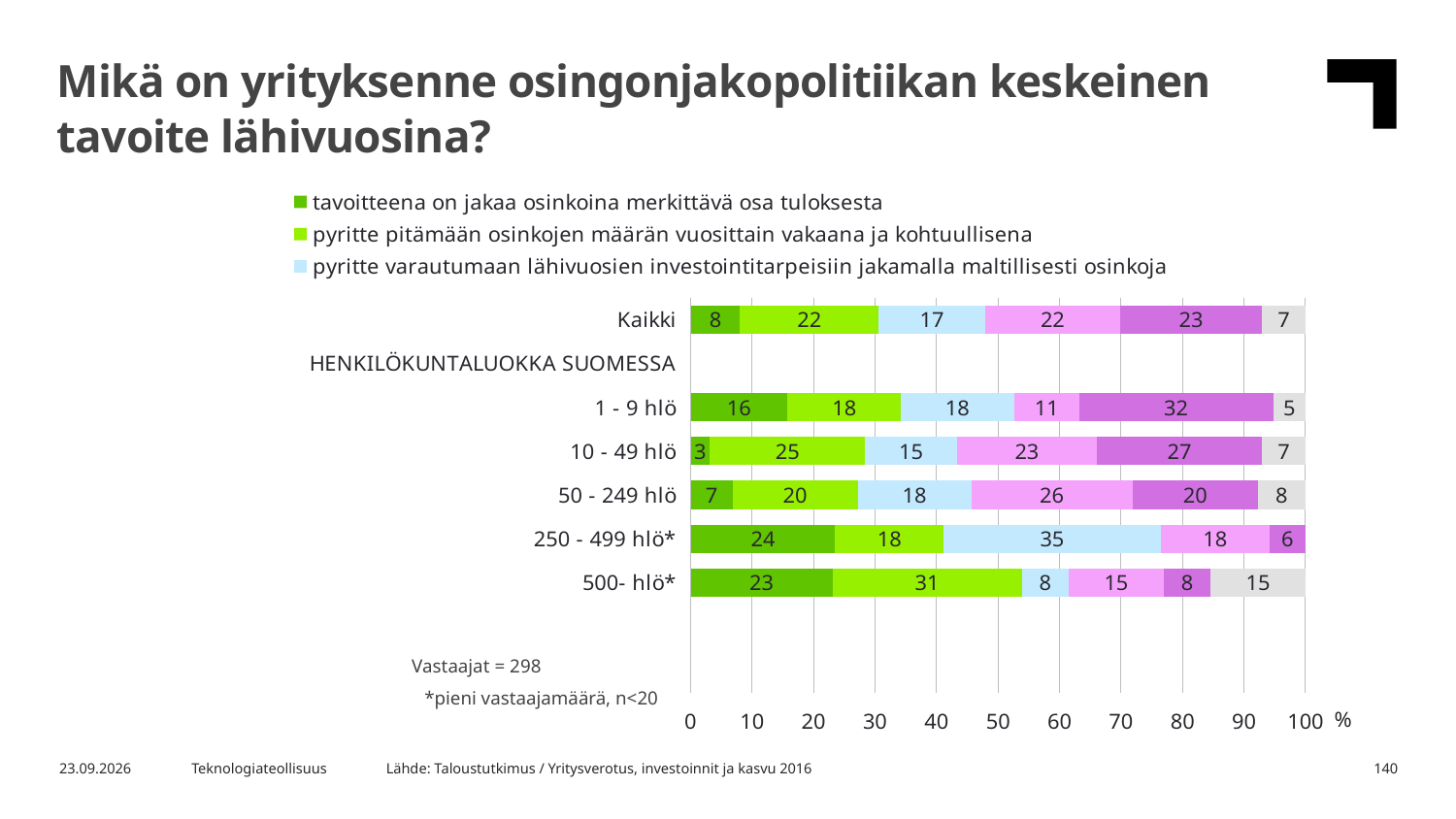
How many entries does the chart legend list? 3 How many categories have bars plotted in the chart? 6 What type of chart is shown on the slide? Stacked bar chart Which category has the highest value for 'pyritte varautumaan lähivuosien investointitarpeisiin jakamalla maltillisesti osinkoja'? 250 - 499 hlö* What is the value of the 'tavoitteena on jakaa osinkoina merkittävä osa tuloksesta' segment for Kaikki? 8 What is the value of the 'pyritte pitämään osinkojen määrän vuosittain vakaana ja kohtuullisena' segment for 500- hlö*? 31 For Kaikki, what is the difference between the 'pyritte pitämään osinkojen määrän vuosittain vakaana ja kohtuullisena' segment and the 'tavoitteena on jakaa osinkoina merkittävä osa tuloksesta' segment? 14 How many respondents (Vastaajat) does the slide report? 298 What is the value of the 'pyritte varautumaan lähivuosien investointitarpeisiin jakamalla maltillisesti osinkoja' segment for 250 - 499 hlö*? 35 What is the total of all segments in the 1 - 9 hlö bar? 100 Which has a larger value for 'tavoitteena on jakaa osinkoina merkittävä osa tuloksesta': 1 - 9 hlö or 50 - 249 hlö? 1 - 9 hlö Which category has the lowest value for 'tavoitteena on jakaa osinkoina merkittävä osa tuloksesta'? 10 - 49 hlö